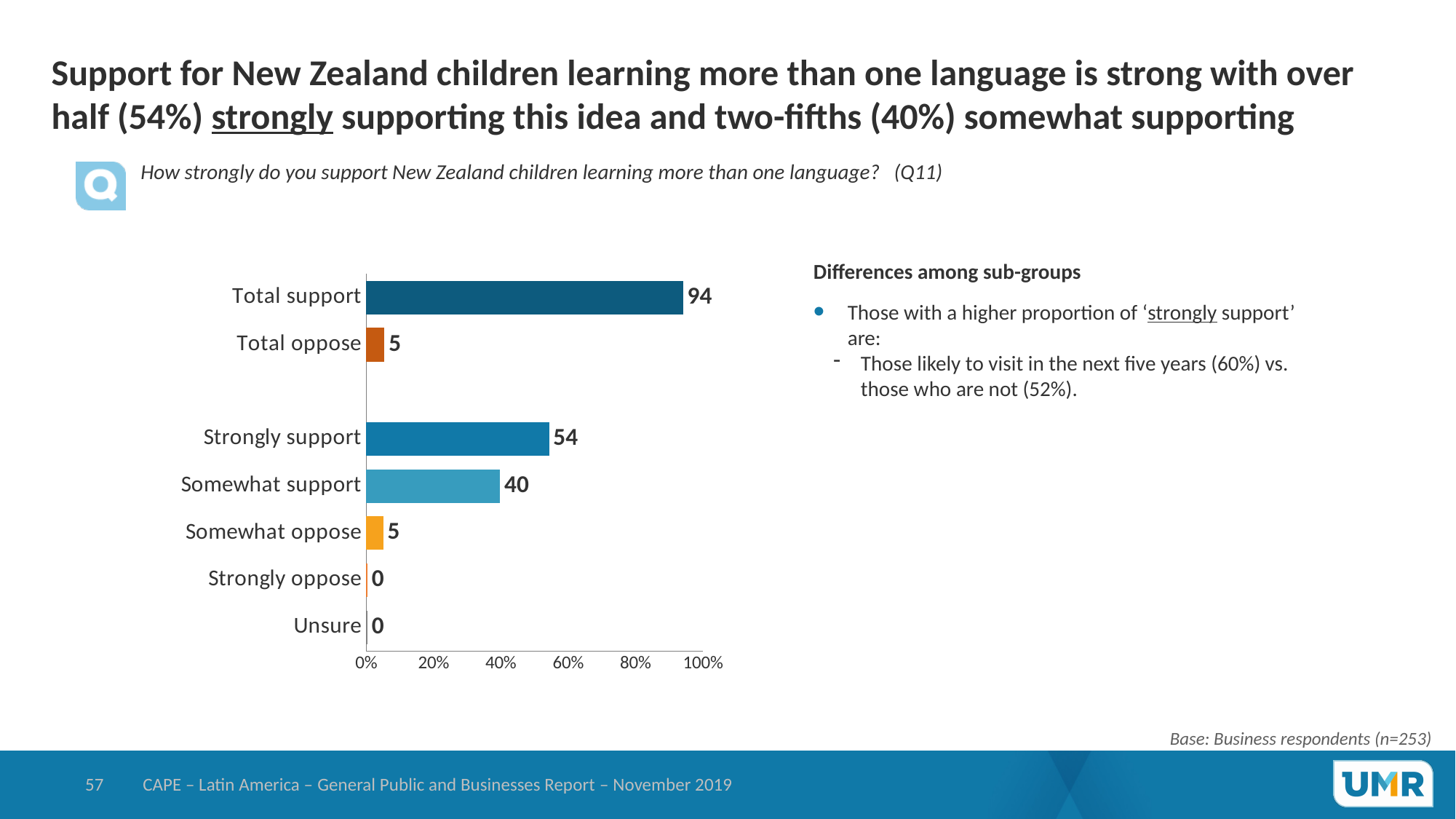
What is the value for Total support? 94 What is the value for Somewhat oppose? 5 Is the value for Total support greater or less than 80%? greater Which is larger, Strongly support or Somewhat support? Strongly support What is the value for Strongly support? 54 How many categories are shown on the chart? 7 What is the value for Somewhat support? 40 What is the difference between Strongly support and Somewhat support? 14 What is the value for Strongly oppose? 0 Which category has the highest value? Total support What is the difference between Total support and Total oppose? 89 What kind of chart is shown on the slide? Bar chart